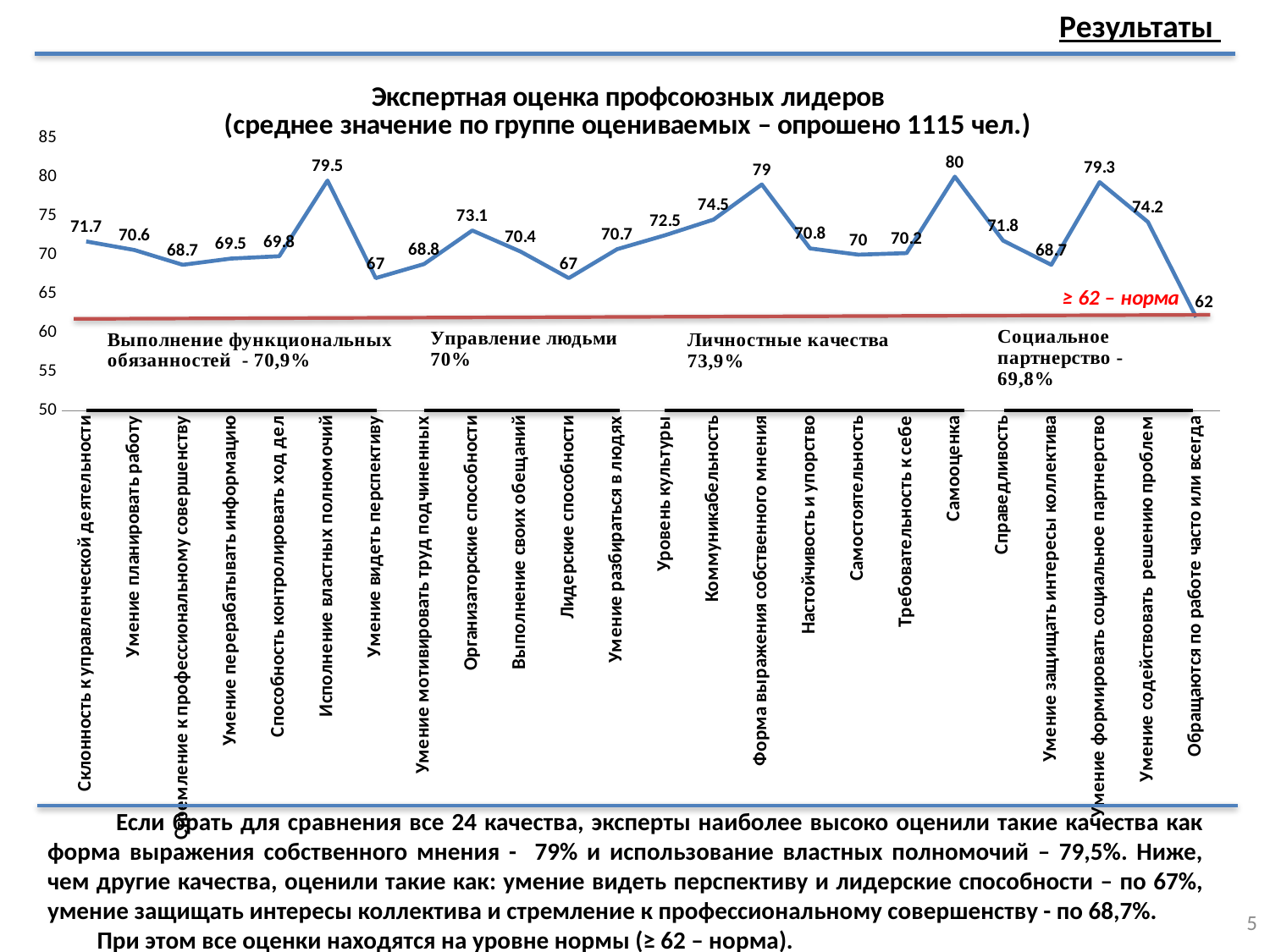
What type of chart is shown on the slide? Line chart What is the value for Самооценка? 80 What is the value for Исполнение властных полномочий? 79.5 What is the difference between the values for Форма выражения собственного мнения and Настойчивость и упорство? 8.2 What is the difference between the values for Коммуникабельность and Уровень культуры? 2 Which category has the lowest value on the chart? Обращаются по работе часто или всегда What is the value for Лидерские способности? 67 Which is larger, the value for Организаторские способности or the value for Умение содействовать решению проблем? Умение содействовать решению проблем Which category has the highest value on the chart? Самооценка What is the value for Умение формировать социальное партнерство? 79.3 How many categories are plotted on the chart? 24 What norm threshold is marked by the red line on the chart? ≥ 62 – норма